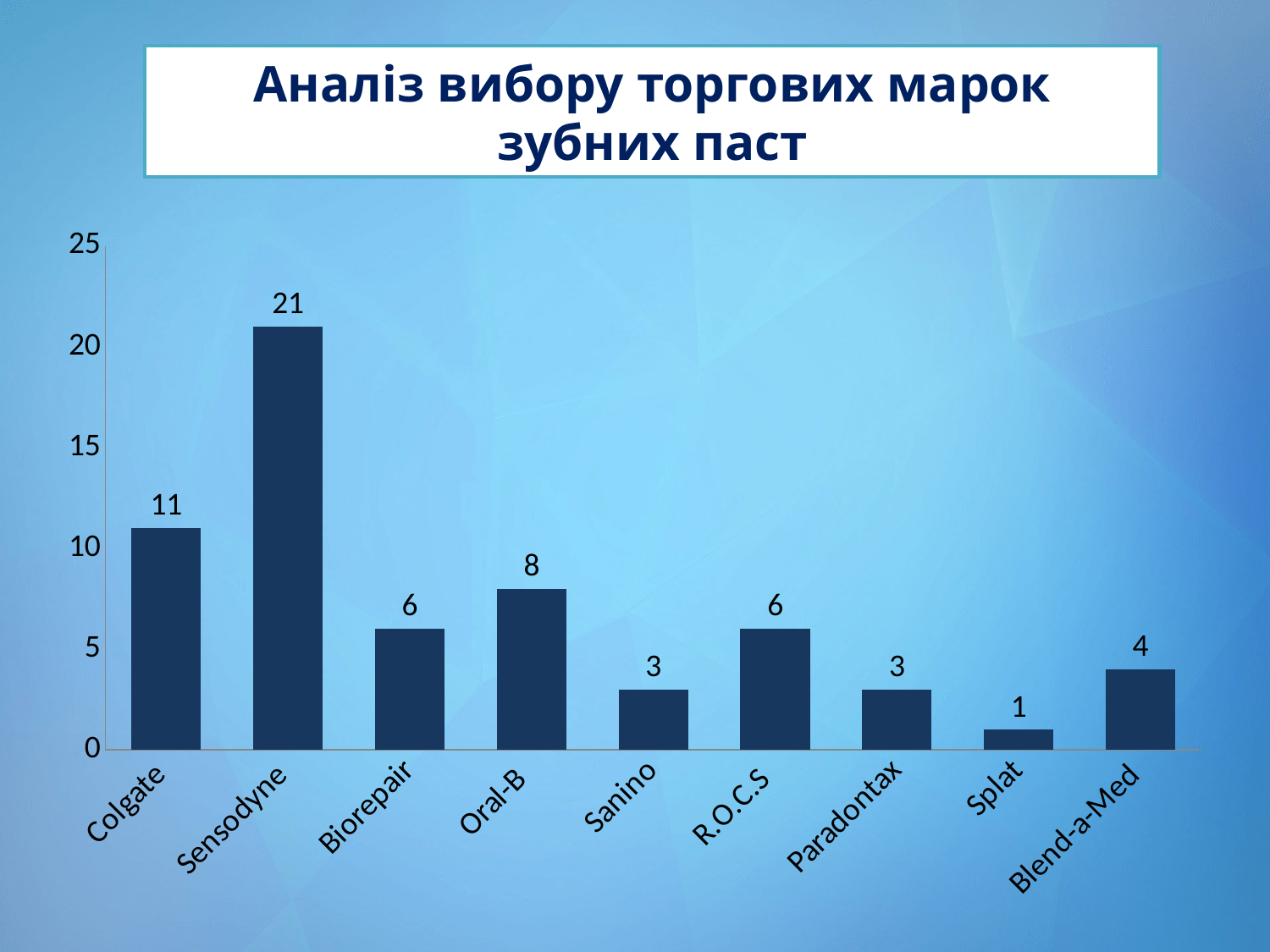
Which brand has the lowest value? Splat What is the value for Colgate? 11 What is the difference between the values for Oral-B and Sanino? 5 Which is larger, the value for Oral-B or the value for Biorepair? Oral-B How many brands are shown on the chart? 9 What is the value for Blend-a-Med? 4 What is the value for Sensodyne? 21 Is the value for Colgate greater or less than 10? greater Which brand has the highest value? Sensodyne What is the difference between the values for Sensodyne and Colgate? 10 What kind of chart is shown on the slide? bar chart What is the title of the slide? Аналіз вибору торгових марок зубних паст